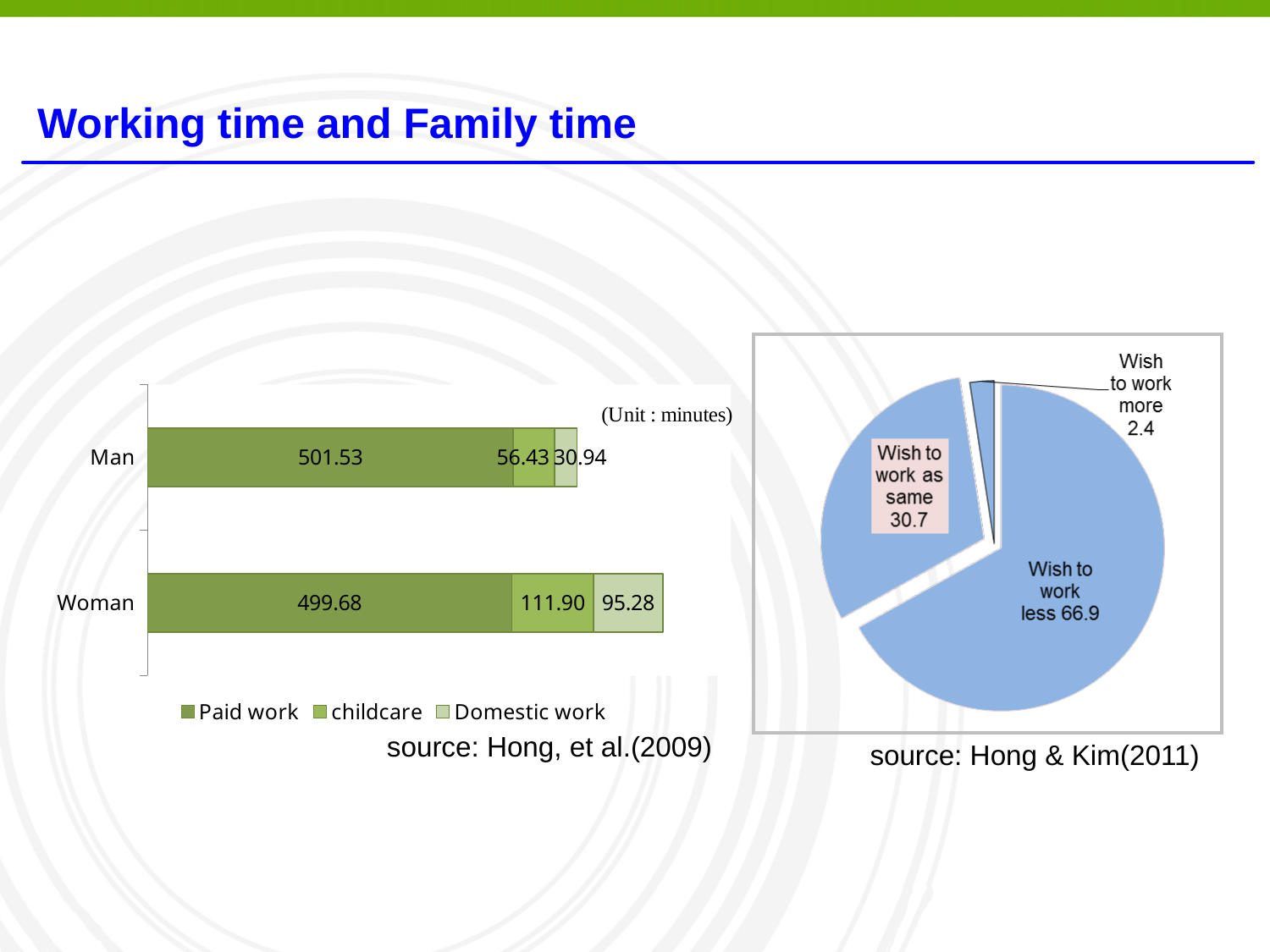
In the left bar chart, what unit are the values given in? minutes In the left bar chart, which category has the larger domestic work value, Man or Woman? Woman What kind of chart is the chart on the left of the slide? Stacked bar chart In the left bar chart, what is the paid work value for Man? 501.53 In the left bar chart, what is the childcare value for Woman? 111.90 In the left bar chart, what is the domestic work value for Man? 30.94 In the right pie chart, which slice is the smallest? Wish to work more In the left bar chart, how many series does the legend list? 3 In the right pie chart, what is the value for 'Wish to work less'? 66.9 In the left bar chart, what is the total of the stacked bar for Woman? 706.86 In the right pie chart, what is the difference between 'Wish to work less' and 'Wish to work as same'? 36.2 In the left bar chart, what is the difference between the childcare values for Woman and Man? 55.47